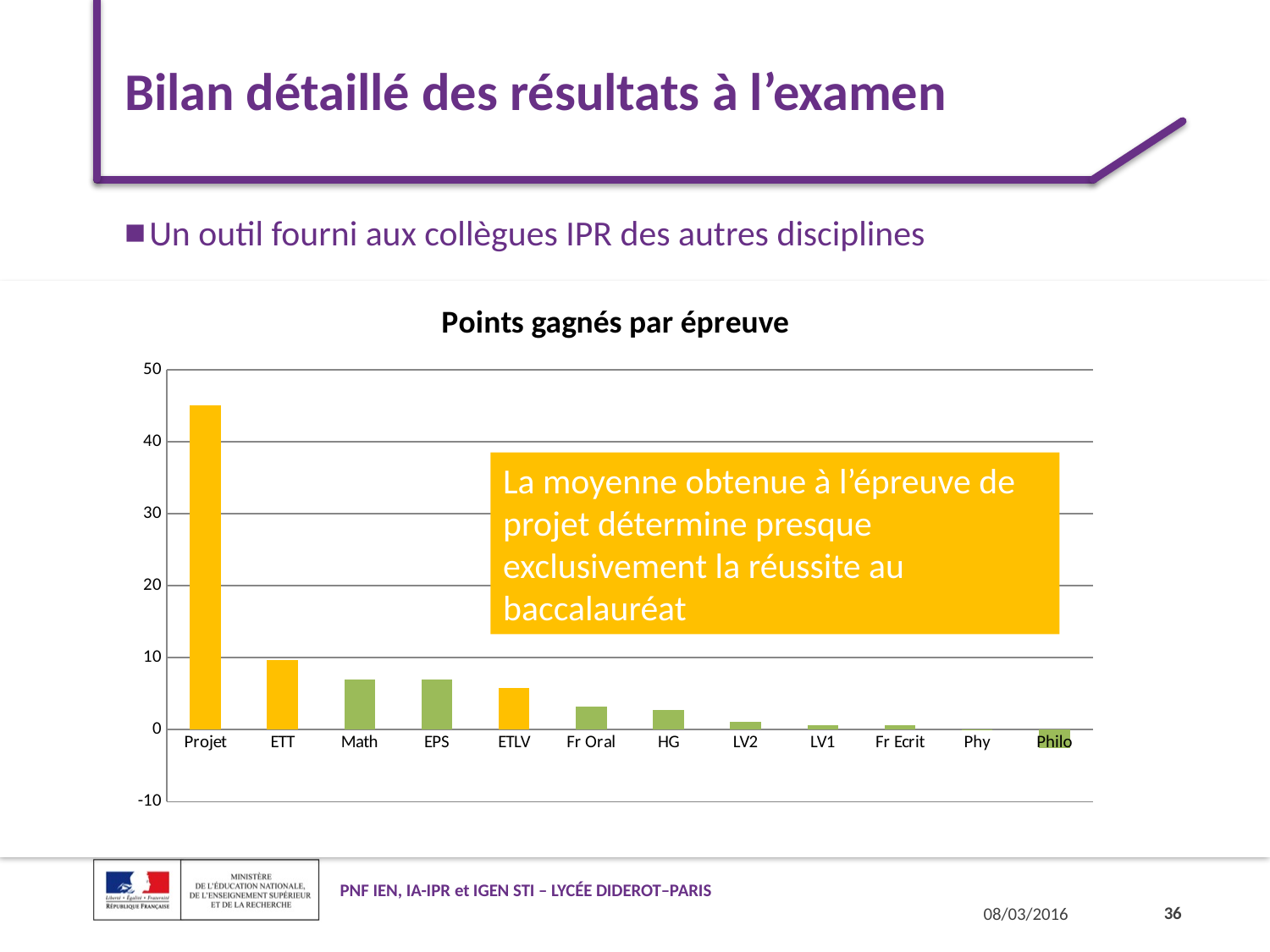
Do the values generally rise or fall moving from left to right along the x axis? fall Is the value for Math greater or less than 10? less What colour is the bar for Projet? yellow Which épreuve has the highest value in the chart? Projet How many categories (épreuves) are shown on the x axis of the chart? 12 Is the value for Fr Oral greater or less than 10? less Which is larger, the value for ETT or the value for Fr Oral? ETT Which is larger, the value for Projet or the value for ETT? Projet What kind of chart is shown on the slide? bar chart Is the value for Projet greater or less than 40? greater What is the title of the chart? Points gagnés par épreuve